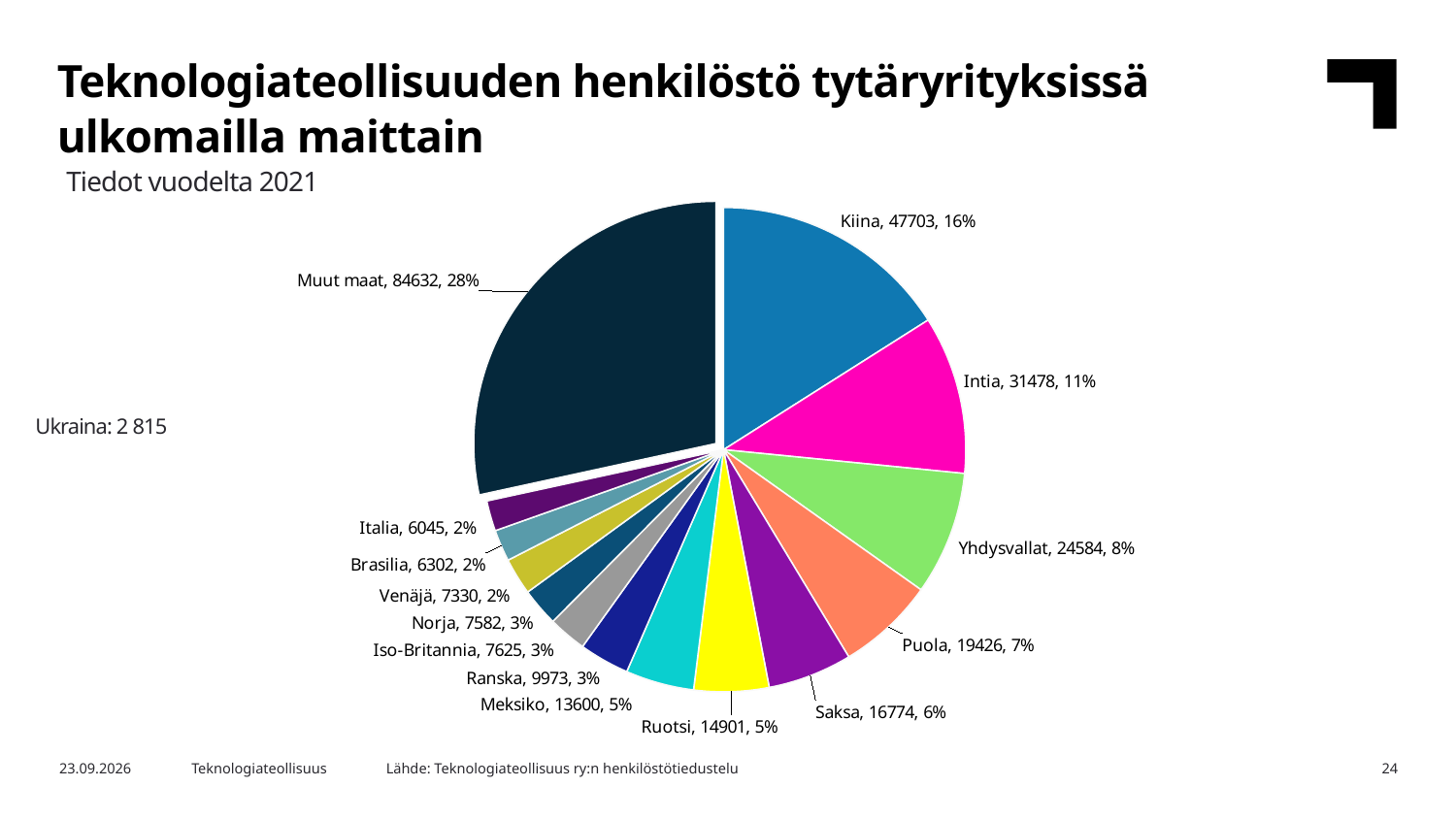
What is the value for Meksiko? 13600 Which is larger, the value for Puola or the value for Saksa? Puola What is the difference between the values for Ruotsi and Meksiko? 1301 Which labelled slice has the largest value? Muut maat Which labelled slice has the smallest value? Italia What is the value for Yhdysvallat? 24584 What is the difference between the values for Kiina and Intia? 16225 What kind of chart is shown on the slide? pie chart What year do the data on the slide come from, according to the subtitle? 2021 What percentage share is shown for Intia? 11% What share of the pie does Muut maat represent? 28% What is the value for Kiina? 47703